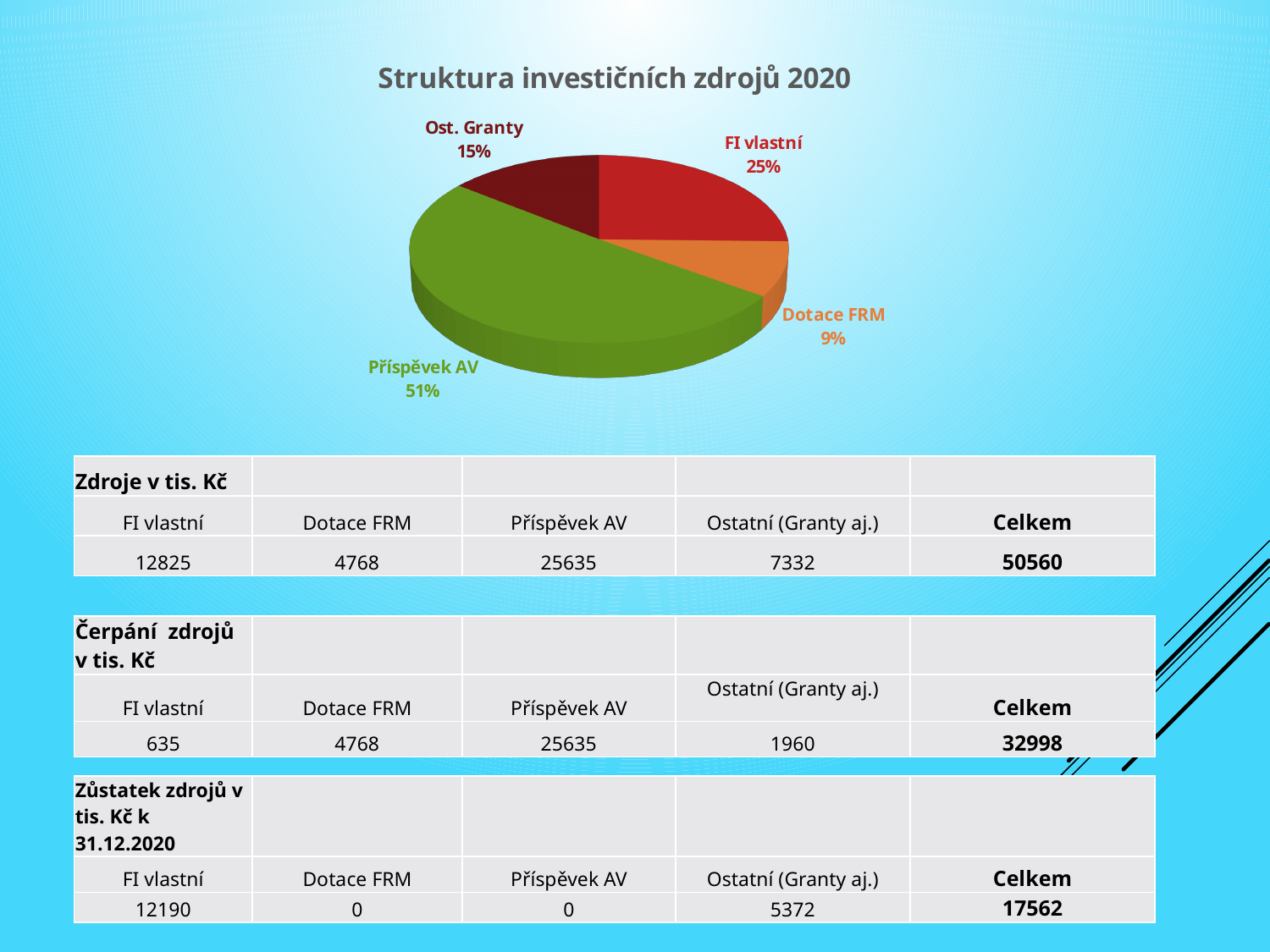
What kind of chart is shown on the slide? pie chart What share of the pie does Ost. Granty represent? 15% What colour is the Příspěvek AV slice of the pie? green What share of the pie does Příspěvek AV represent? 51% What is the difference in percentage points between the Příspěvek AV share and the FI vlastní share? 26 What is the title of the chart? Struktura investičních zdrojů 2020 How many slices does the pie chart have? 4 What share of the pie does Dotace FRM represent? 9% Which slice of the pie is the largest? Příspěvek AV Which is larger, the share for FI vlastní or the share for Ost. Granty? FI vlastní Which slice of the pie is the smallest? Dotace FRM